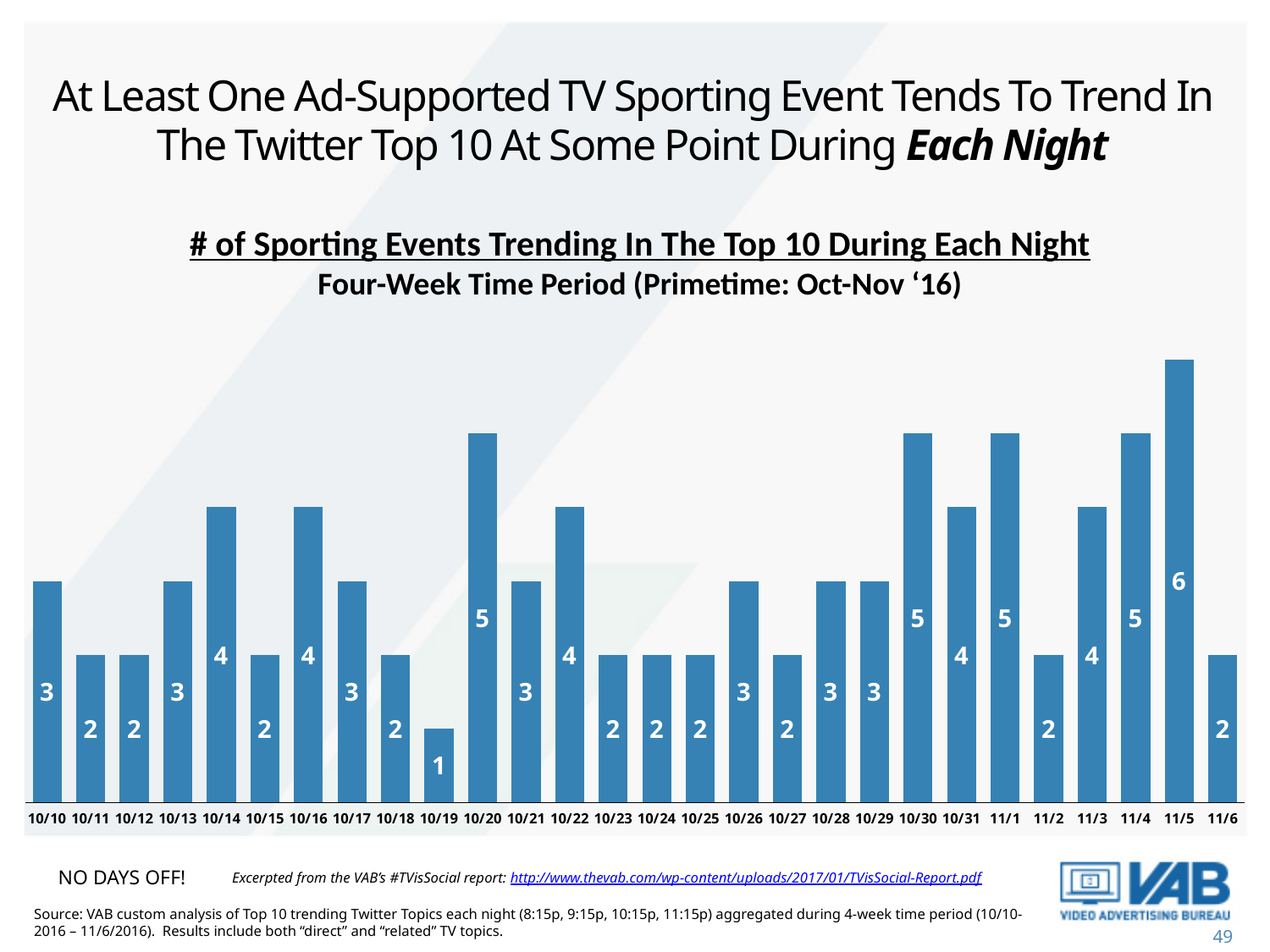
What is the difference between the values for 11/5 and 10/19? 5 What is the difference between the values for 10/30 and 10/31? 1 What time period does the chart subtitle say the data covers? Four-Week Time Period (Primetime: Oct-Nov '16) Which is larger, the value for 11/4 or the value for 11/6? 11/4 What is the value shown for 10/19? 1 What is the value shown for 10/20? 5 How many sporting events trended in the Top 10 on 11/5? 6 How many nights (bars) are shown on the chart? 28 Which night has the lowest number of sporting events trending in the Top 10? 10/19 Which is larger, the value for 10/14 or the value for 10/15? 10/14 Which night has the highest number of sporting events trending in the Top 10? 11/5 What type of chart is used on this slide? Bar chart